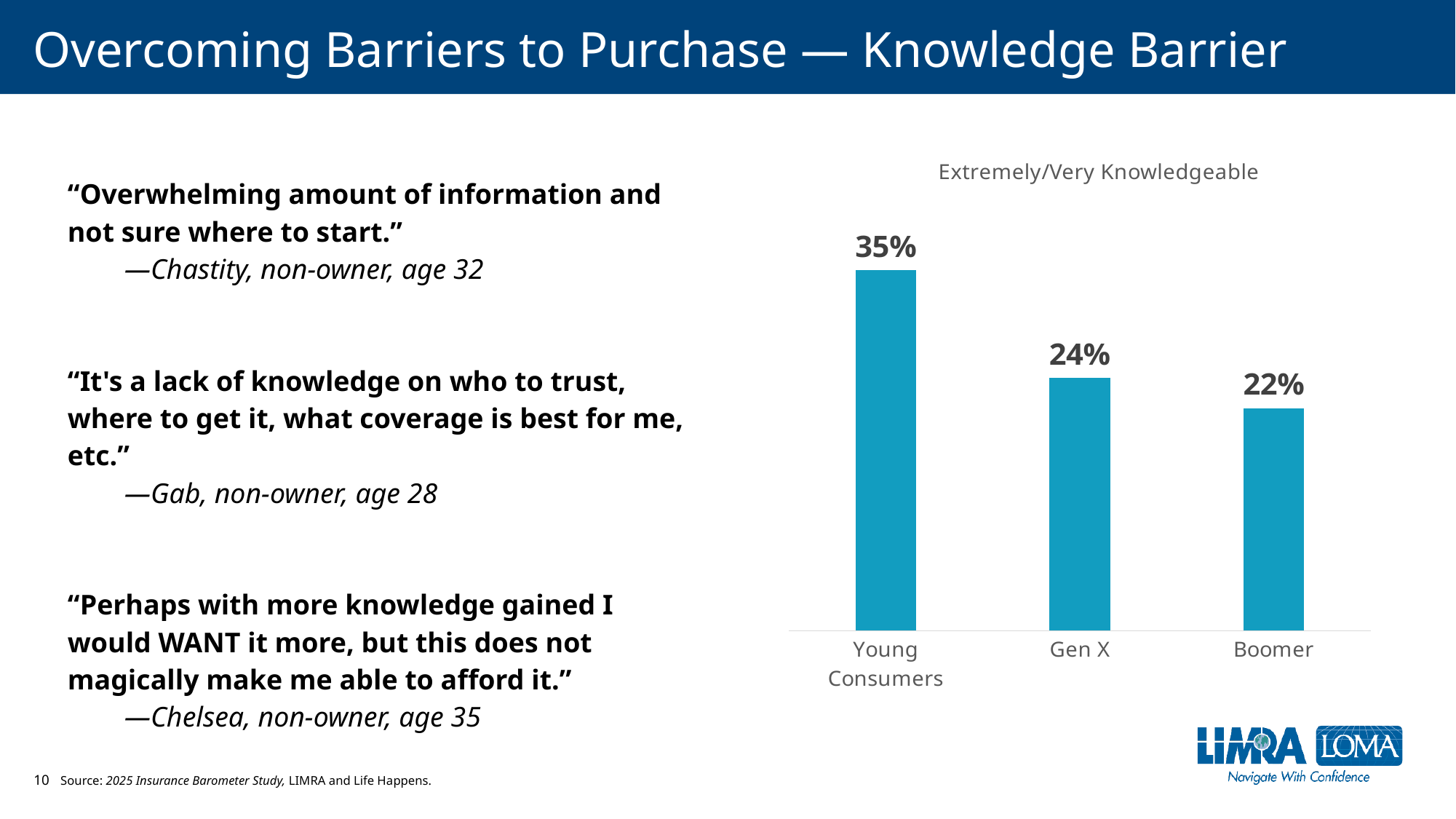
What kind of chart is shown on the slide? Bar chart Which category has the highest value? Young Consumers How many categories are shown in the chart? 3 What is the title of the chart? Extremely/Very Knowledgeable Which is larger, the value for Young Consumers or the value for Boomer? Young Consumers What is the difference between the values for Young Consumers and Boomer? 13% What is the value for Young Consumers? 35% What is the value for Boomer? 22% What is the difference between the values for Gen X and Boomer? 2% What is the value for Gen X? 24% What is the difference between the values for Young Consumers and Gen X? 11% Which category has the lowest value? Boomer